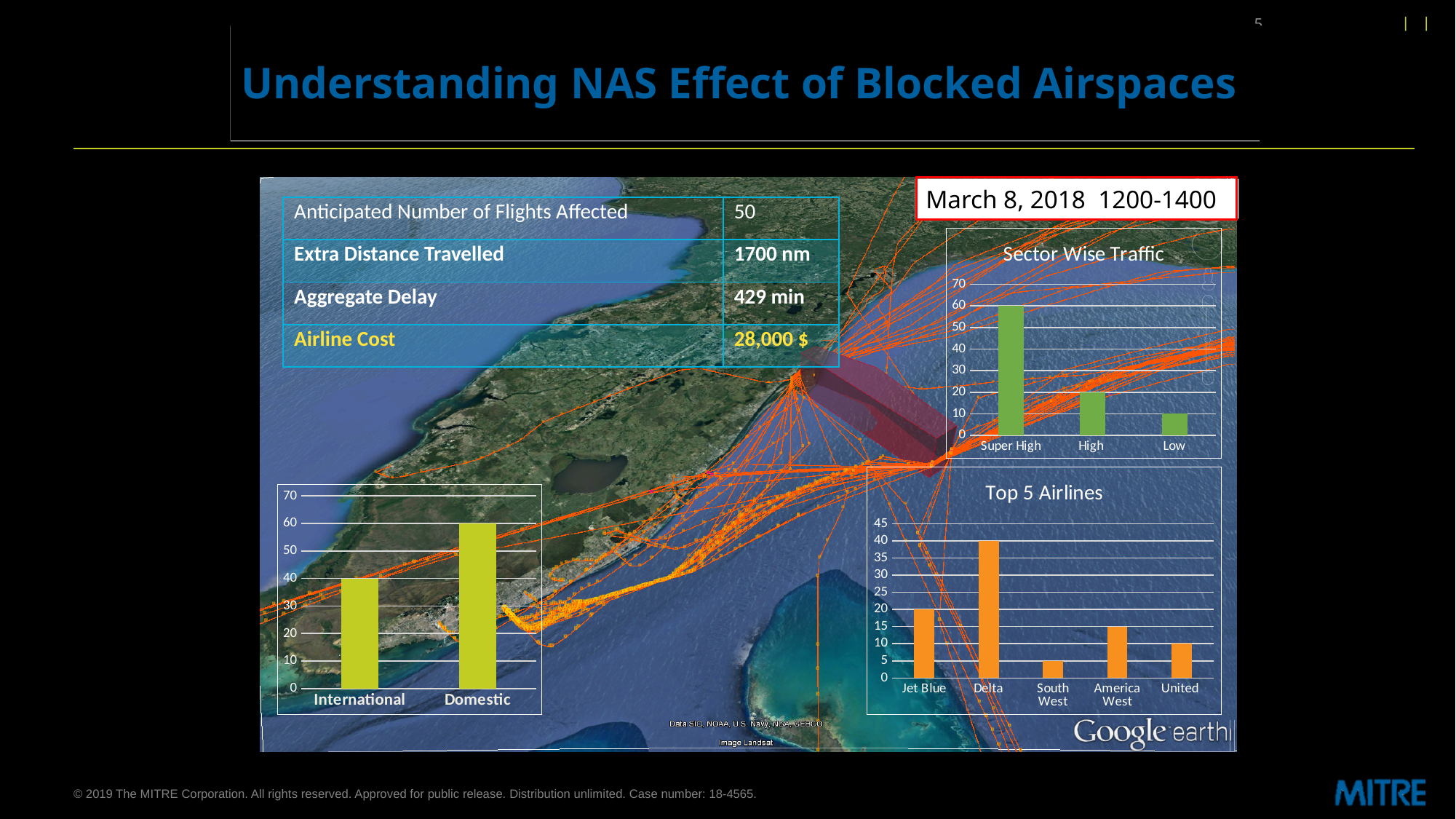
What type of chart is the Top 5 Airlines chart? bar chart In the Sector Wise Traffic chart, is the value for Super High greater or less than 50? greater In the Sector Wise Traffic chart, which sector has the lowest traffic? Low In the Top 5 Airlines chart, is the value for Jet Blue larger or smaller than the value for United? larger In the Top 5 Airlines chart, which airline has the lowest value? South West In the Top 5 Airlines chart, is the value for Delta greater or less than 35? greater In the Top 5 Airlines chart, which airline has the highest value? Delta In the Sector Wise Traffic chart, how many sectors are shown? 3 In the bottom-left chart with International and Domestic bars, which category has the higher value? Domestic In the bottom-left chart with International and Domestic bars, is the value for International greater or less than 30? greater In the Sector Wise Traffic chart, which sector has the highest traffic? Super High In the Top 5 Airlines chart, how many airlines are shown? 5